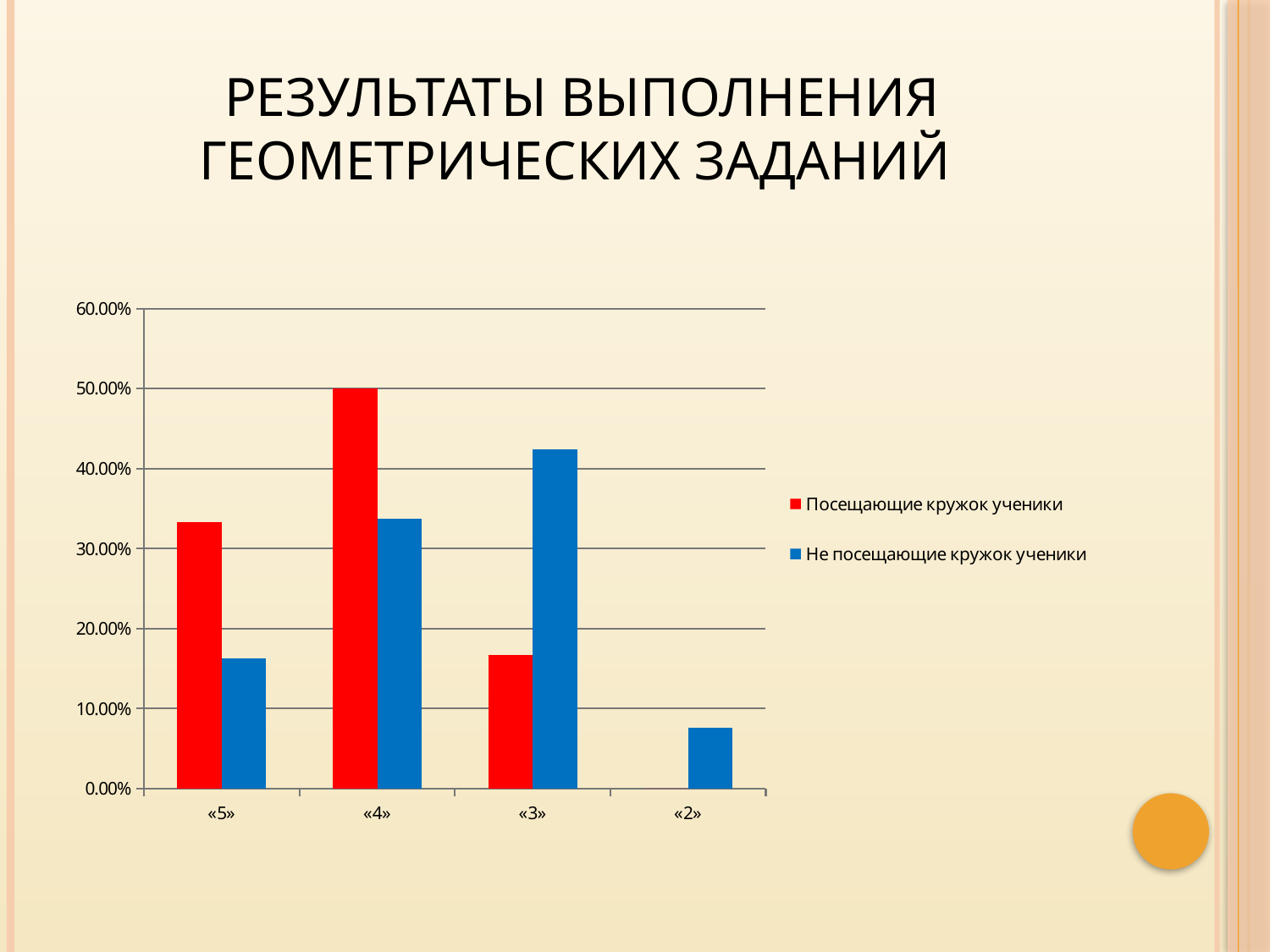
Which category has the highest value for «Не посещающие кружок ученики»? «3» Which category has the lowest value for «Не посещающие кружок ученики»? «2» Which category has the highest value for «Посещающие кружок ученики»? «4» For category «5», which series has the larger value? Посещающие кружок ученики How many series does the legend list? 2 How many categories are shown on the x axis? 4 For category «3», which series has the larger value? Не посещающие кружок ученики Which colour represents «Не посещающие кружок ученики» in the chart? blue Is the value for «Посещающие кружок ученики» at «5» greater or less than 30.00%? greater What kind of chart is shown on the slide? bar chart Is the value for «Не посещающие кружок ученики» at «2» greater or less than 10.00%? less Is the value for «Не посещающие кружок ученики» at «3» greater or less than 40.00%? greater